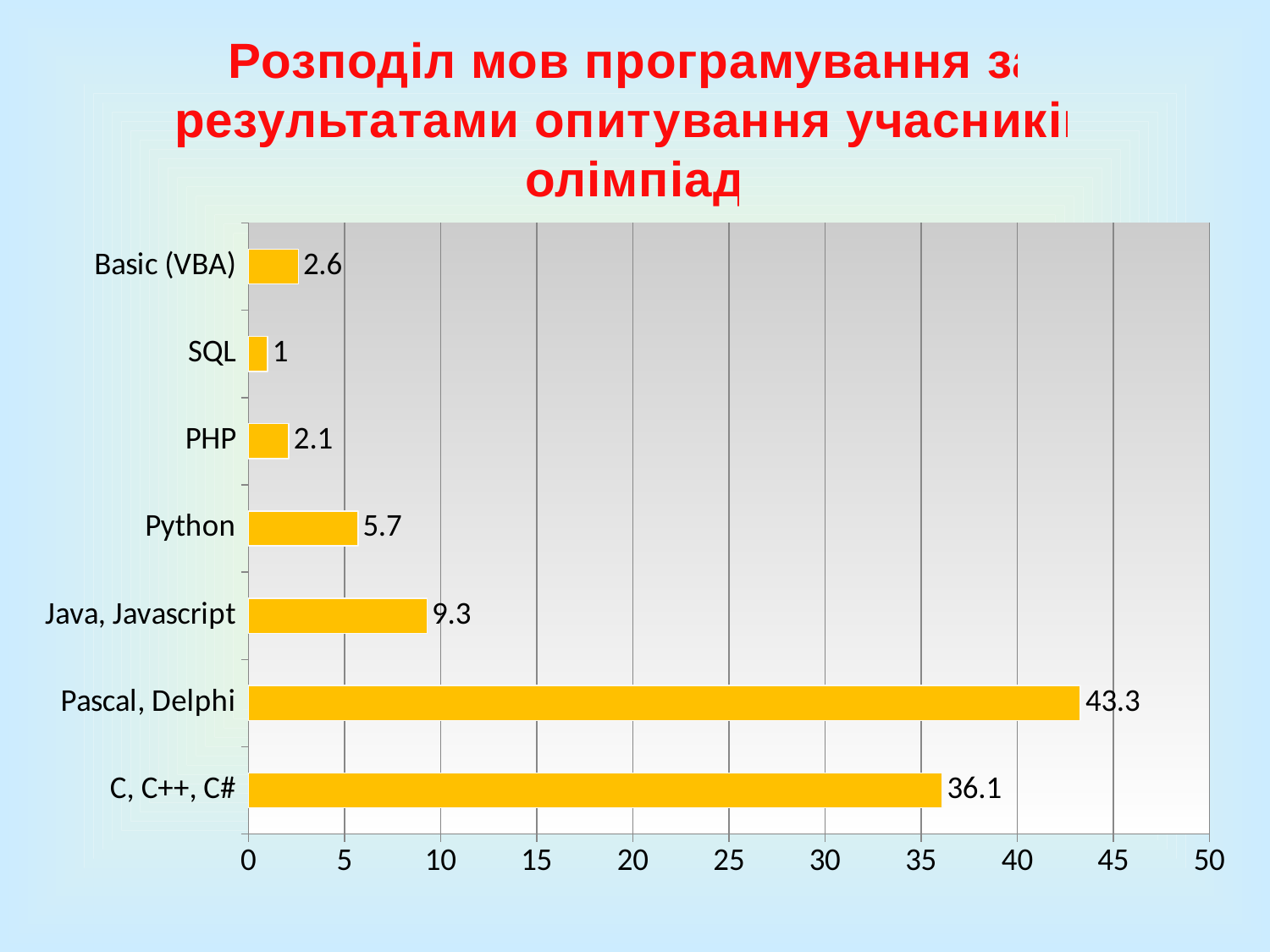
What kind of chart is shown on the slide? bar chart What is the difference between the values for Basic (VBA) and PHP? 0.5 Which category has the lowest value? SQL Is the value for C, C++, C# greater or less than 30? greater Which category has the highest value? Pascal, Delphi What is the value for SQL? 1 What colour are the bars in the chart? yellow/orange What is the difference between the values for Pascal, Delphi and C, C++, C#? 7.2 What is the value for Python? 5.7 Which is larger, the value for Java, Javascript or the value for Python? Java, Javascript How many categories are shown in the chart? 7 What is the value for Pascal, Delphi? 43.3